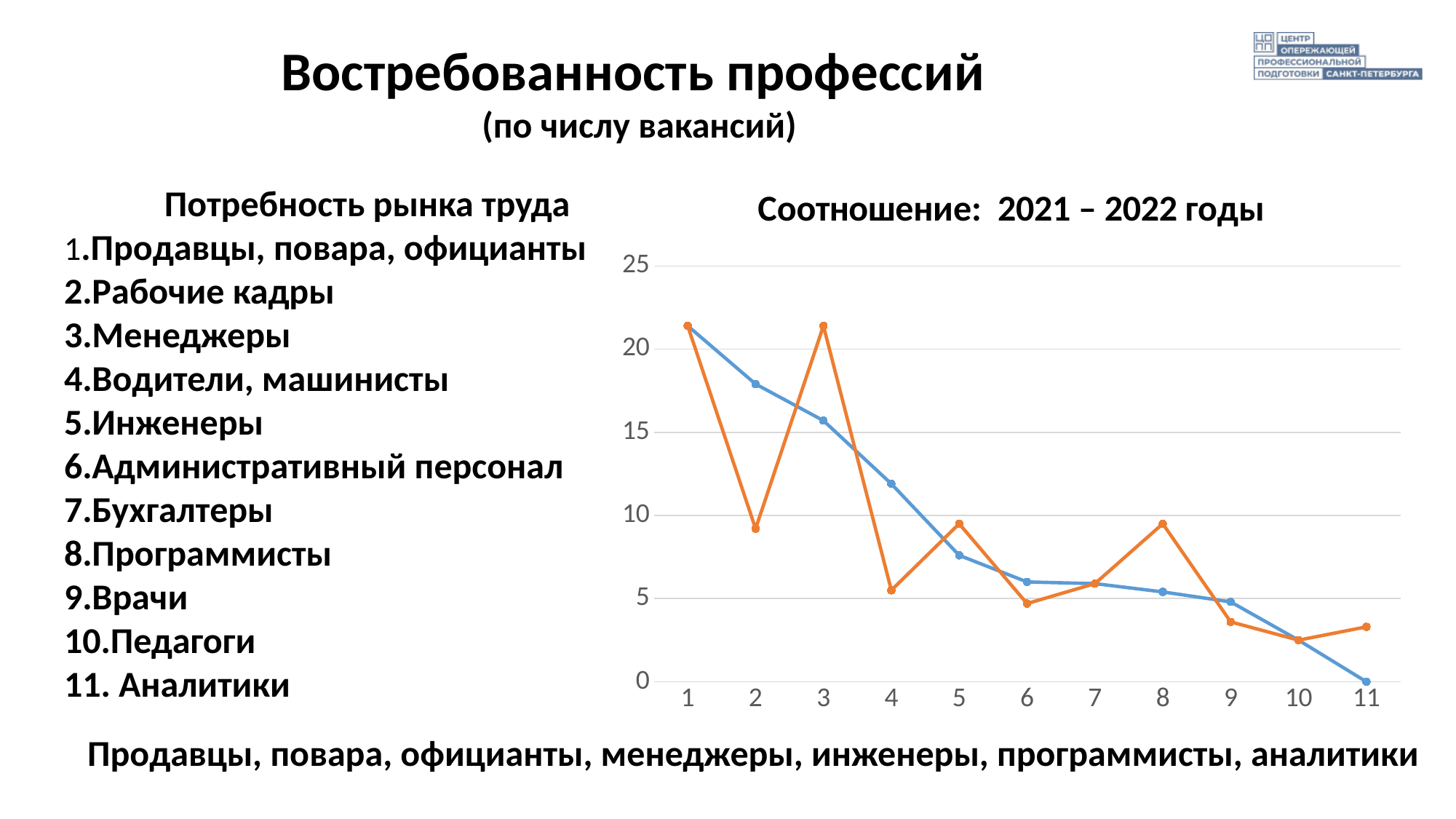
Is the value of the orange line at x = 8 greater or less than 5? greater Is the value of the blue line at x = 2 greater or less than 15? greater What kind of chart is shown on the slide? line chart At which x value does the blue line reach its lowest point? 11 At x = 3, which line has the higher value, the blue line or the orange line? orange line Is the value of the orange line at x = 2 greater or less than 10? less How many lines are plotted on the chart? 2 How many points are labelled along the x axis of the chart? 11 What is the title of the chart? Соотношение: 2021 – 2022 годы Does the blue line generally rise or fall from x = 1 to x = 11? fall